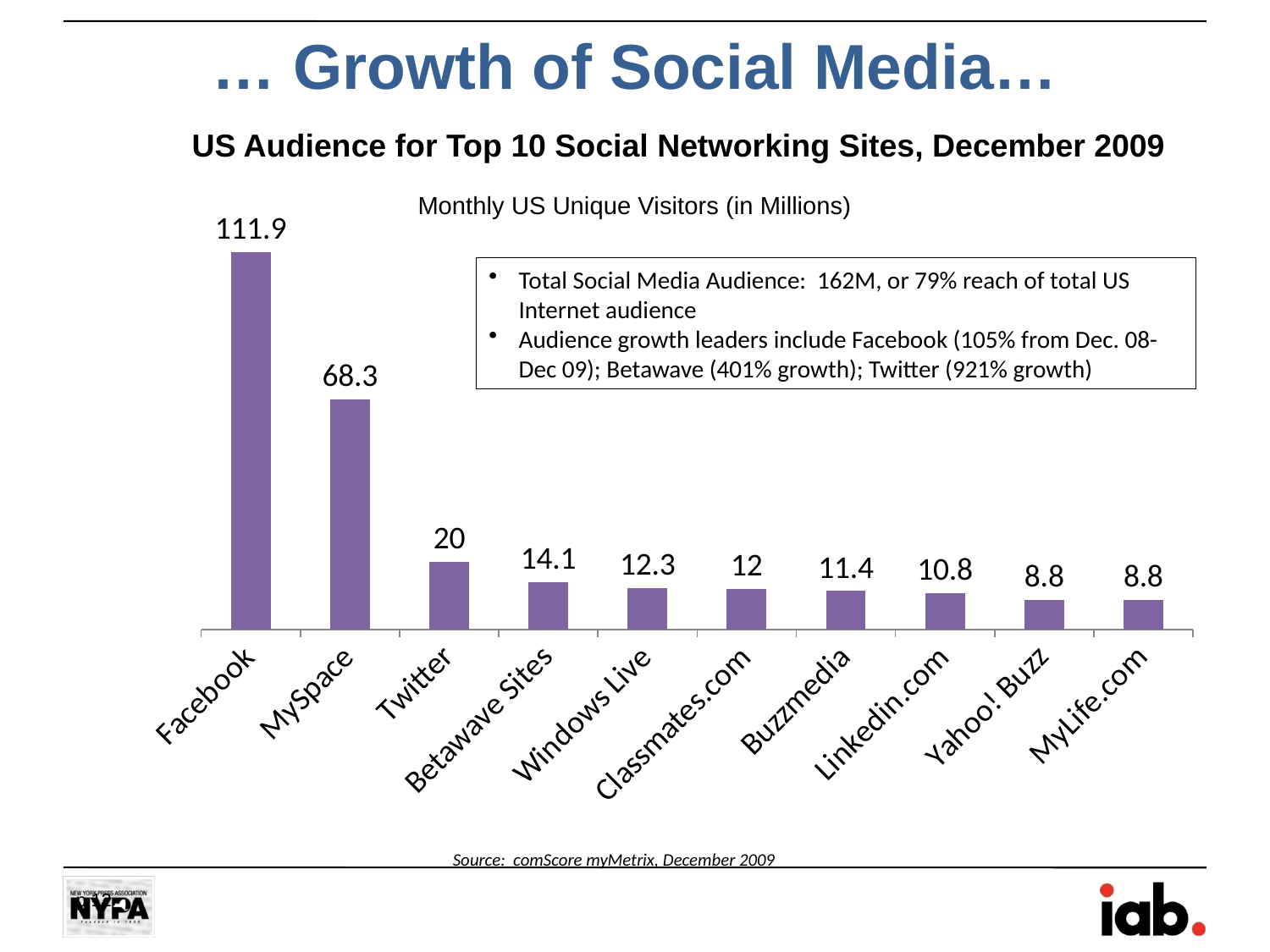
Which is larger, the value for Windows Live or the value for Buzzmedia? Windows Live What is the value for Linkedin.com? 10.8 Do the values rise or fall from left to right along the x axis? Fall How many sites are shown on the chart? 10 What is the value for Yahoo! Buzz? 8.8 What is the difference between the values for Twitter and Betawave Sites? 5.9 What kind of chart is shown on the slide? Bar chart Which site has the highest monthly US unique visitors? Facebook What is the value for Facebook? 111.9 What is the difference between the values for Facebook and MySpace? 43.6 What is the title of the chart? US Audience for Top 10 Social Networking Sites, December 2009 What is the value for Twitter? 20